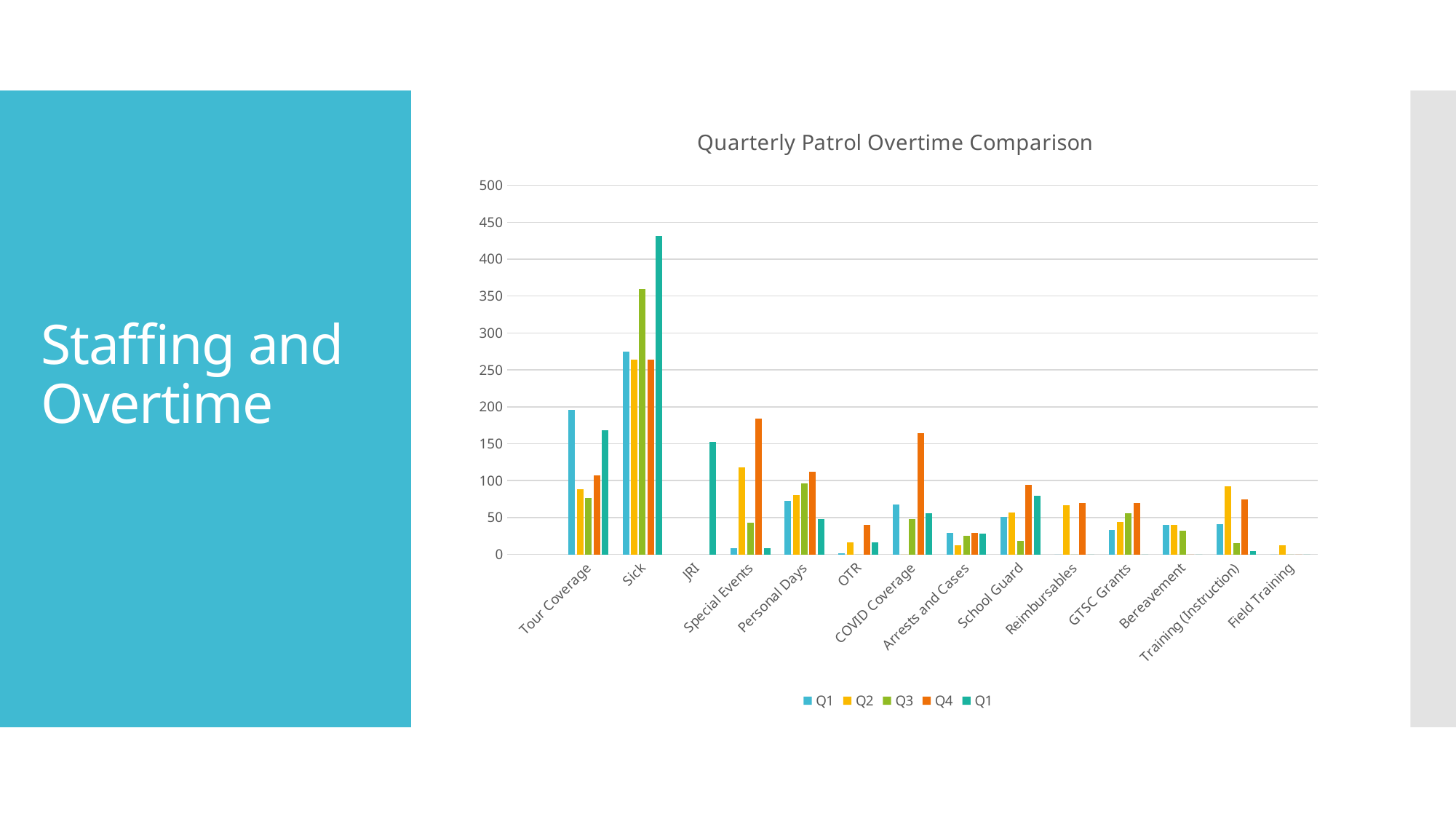
Is the Q3 value for Sick greater or less than 300? greater What is the title of the chart? Quarterly Patrol Overtime Comparison Is the Q4 value for Special Events greater or less than 150? greater Which category has the highest Q4 value? Sick For Special Events, which is larger, the Q2 value or the Q4 value? Q4 How many series does the legend list? 5 Is the Q4 value for COVID Coverage greater or less than 150? greater How many categories are shown on the x axis? 14 Which category has the tallest bar in the chart? Sick For Sick, which is larger, the Q2 value or the Q3 value? Q3 What type of chart is shown on the slide? Bar chart